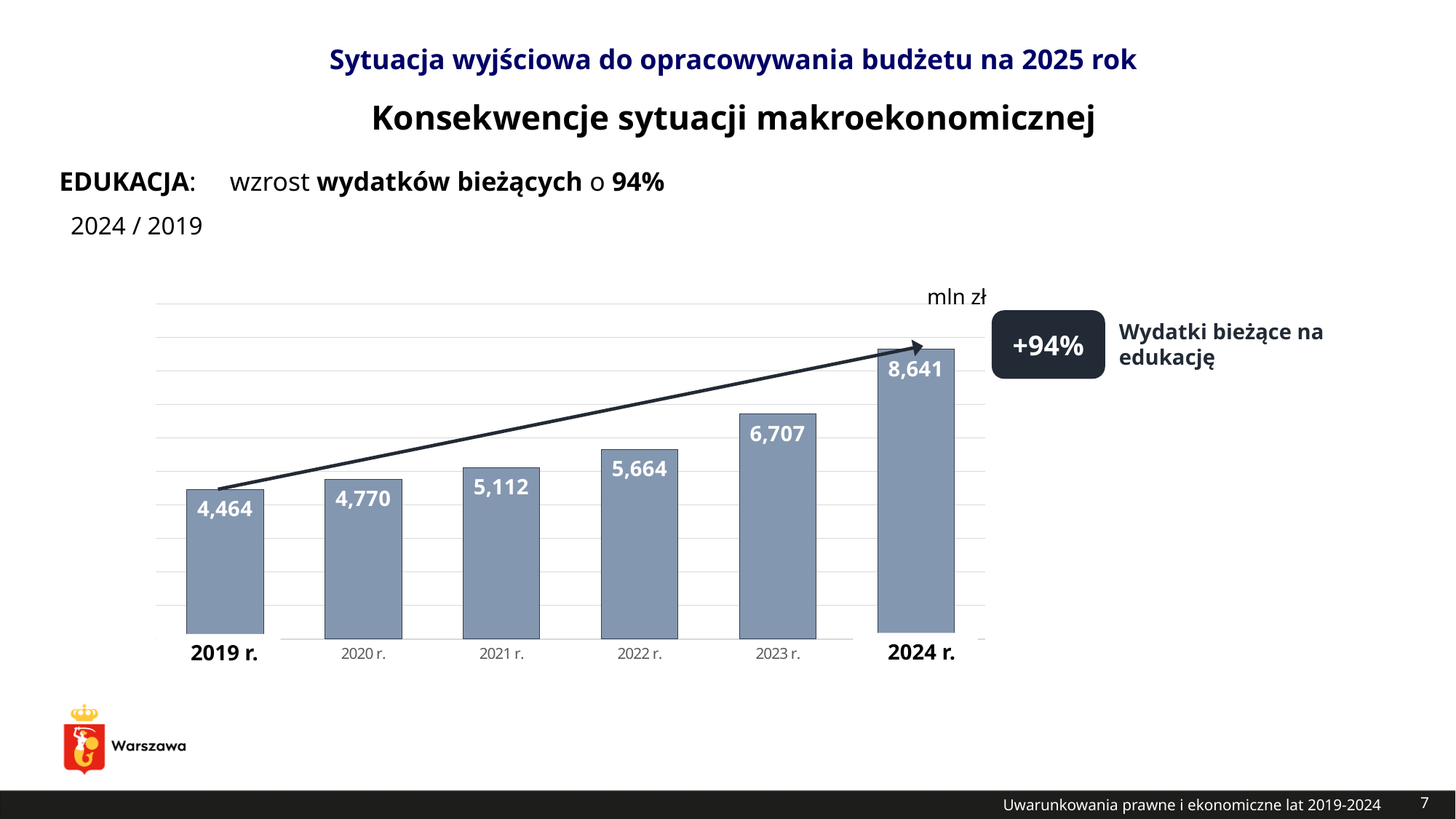
What kind of chart is shown on the slide? bar chart How many years are shown on the chart? 6 Do the values rise or fall from 2019 r. to 2024 r.? rise What is the difference between the values for 2024 r. and 2019 r.? 4,177 What is the value for 2024 r.? 8,641 Which year has the highest value? 2024 r. What percentage change is shown in the box next to the chart? +94% What is the value for 2019 r.? 4,464 Which is larger, the value for 2021 r. or the value for 2020 r.? 2021 r. What is the value for 2022 r.? 5,664 Which year has the lowest value? 2019 r. What is the difference between the values for 2023 r. and 2022 r.? 1,043